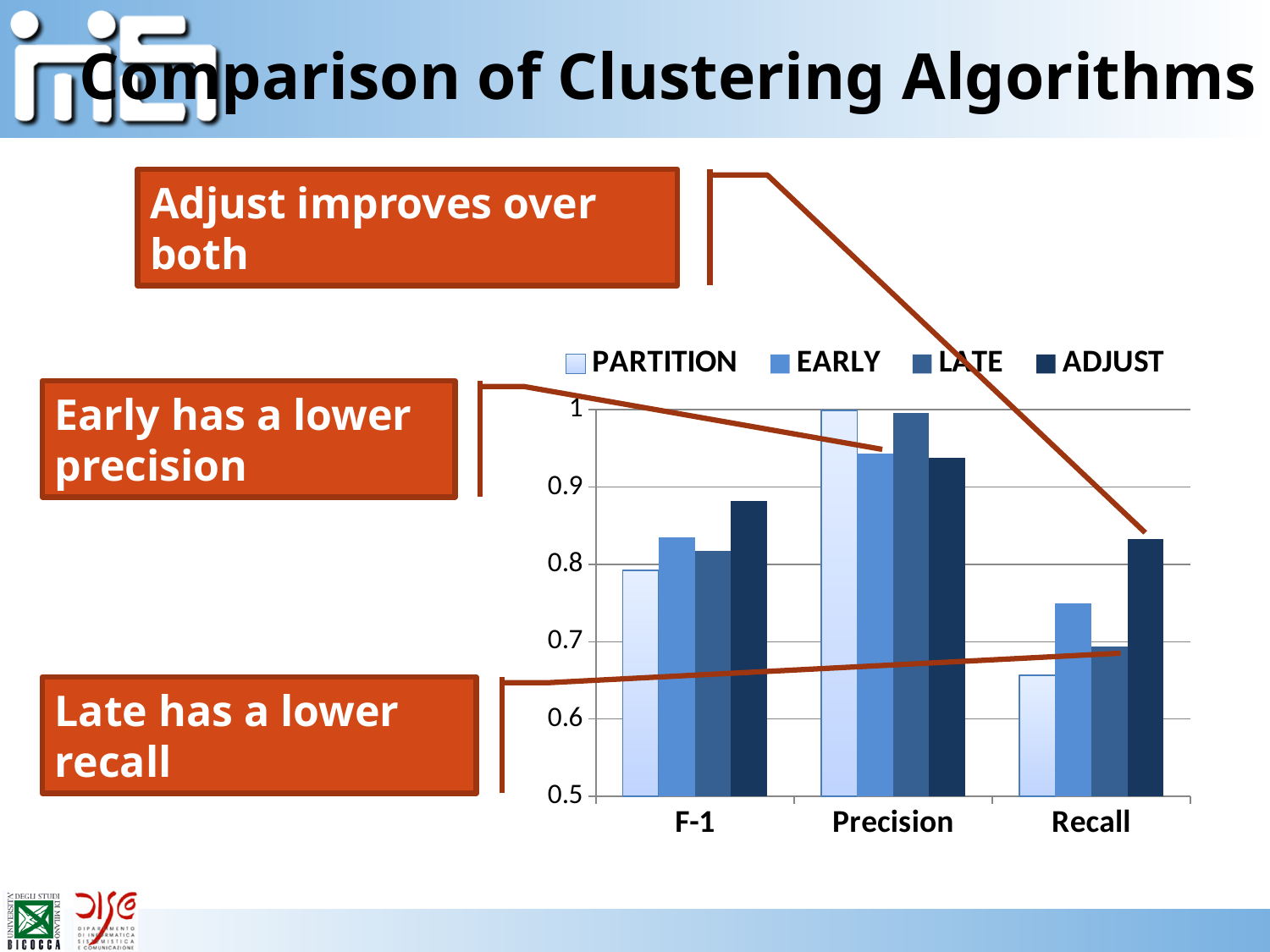
Is the PARTITION value for Recall greater or less than 0.7? less How many series does the chart's legend list? 4 Which series has the lowest value for F-1? PARTITION Is the ADJUST value for F-1 greater or less than 0.9? less What is the title of the slide containing the chart? Comparison of Clustering Algorithms Which series has the highest value for Recall? ADJUST What kind of chart is shown on the slide? bar chart Which series has the lowest value for Recall? PARTITION Is the ADJUST value for Recall greater or less than 0.8? greater For Precision, which is larger: the EARLY value or the LATE value? LATE Which series has the highest value for F-1? ADJUST How many categories are shown on the x axis of the chart? 3